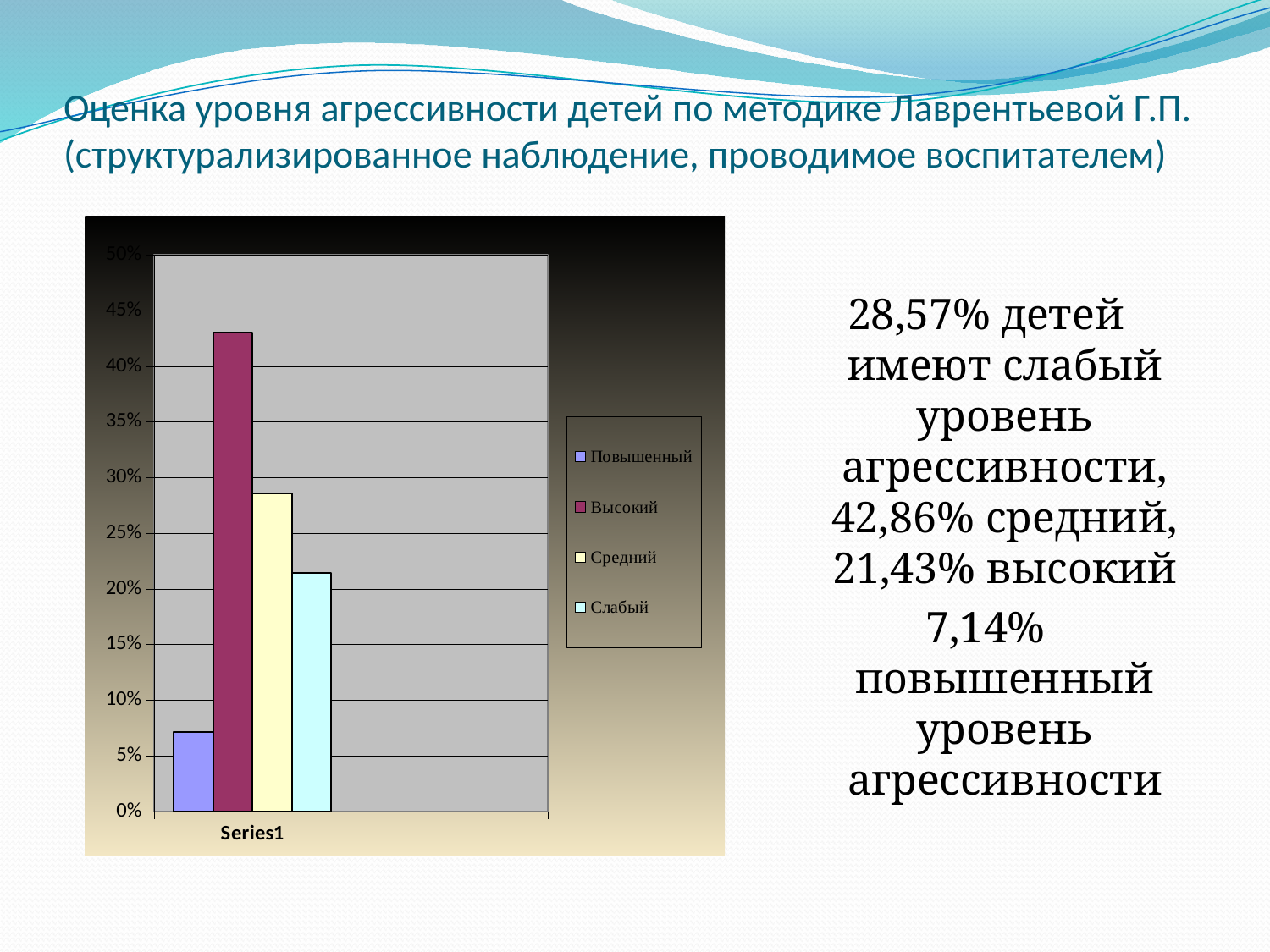
Which series has the shortest bar in the chart? Повышенный What label is shown on the category axis of the chart? Series1 Which series has the tallest bar in the chart? Высокий Is the value for Слабый greater or less than 25%? less Which bar is taller, Средний or Слабый? Средний Is the value for Повышенный greater or less than 10%? less Which bar is taller, Высокий or Средний? Высокий What kind of chart is shown on the slide? bar chart Is the value for Средний greater or less than 30%? less How many series does the chart legend list? 4